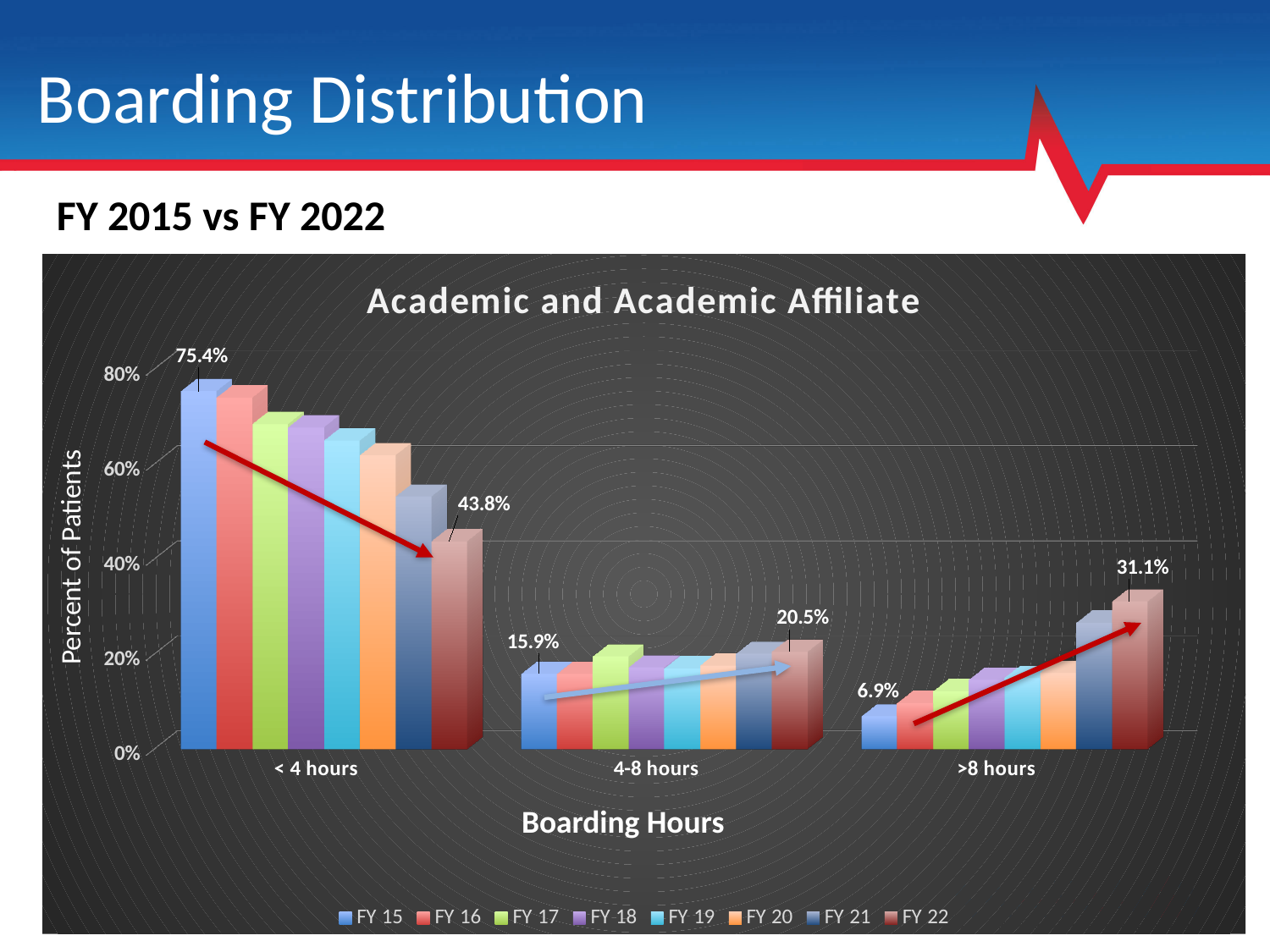
How many boarding-hour categories are shown on the x axis? 3 What is the value for FY 15 in the < 4 hours category? 75.4% Is the value for FY 16 in the < 4 hours category greater or less than 60%? greater What is the value for FY 22 in the >8 hours category? 31.1% What kind of chart is shown on the slide? Bar chart What is the title of the chart? Academic and Academic Affiliate What is the value for FY 22 in the 4-8 hours category? 20.5% What is the value for FY 15 in the 4-8 hours category? 15.9% What is the difference between the FY 22 and FY 15 values in the >8 hours category? 24.2% How many series does the legend list? 8 What is the difference between the FY 15 and FY 22 values in the < 4 hours category? 31.6% Which is larger in the 4-8 hours category: the FY 15 value or the FY 22 value? FY 22